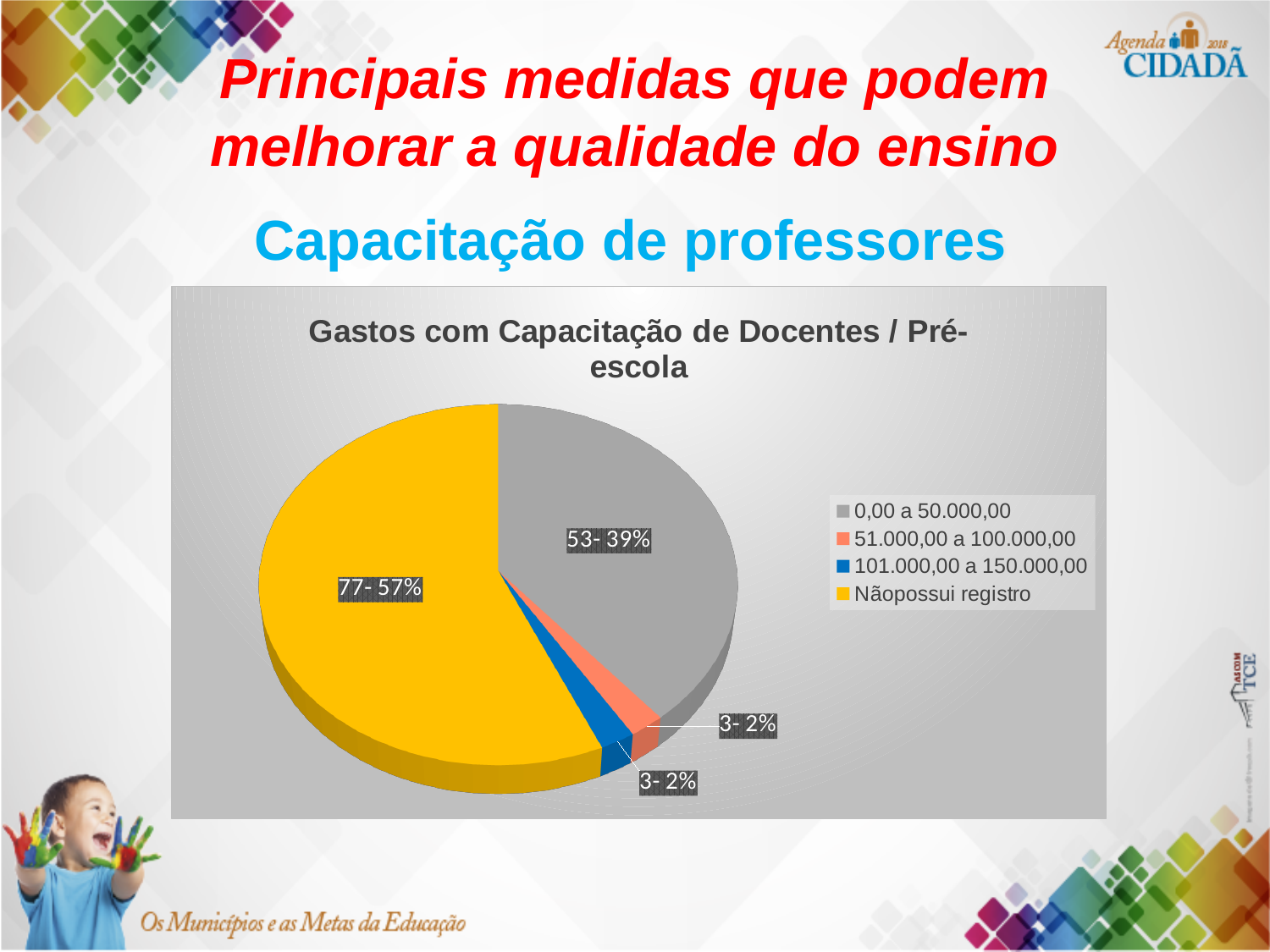
How many slices does the pie chart have? 4 Which category has the largest slice? Não possui registro What count is shown for the '0,00 a 50.000,00' slice? 53 What percentage share does the '51.000,00 a 100.000,00' slice have? 2% What percentage share does the 'Não possui registro' slice have? 57% Which is larger, the '0,00 a 50.000,00' slice or the '101.000,00 a 150.000,00' slice? 0,00 a 50.000,00 What percentage share does the '0,00 a 50.000,00' slice have? 39% What is the difference in count between 'Não possui registro' and '0,00 a 50.000,00'? 24 What is the title of the chart? Gastos com Capacitação de Docentes / Pré-escola What count is shown for the 'Não possui registro' slice? 77 What kind of chart is shown on the slide? pie chart How many entries does the legend list? 4